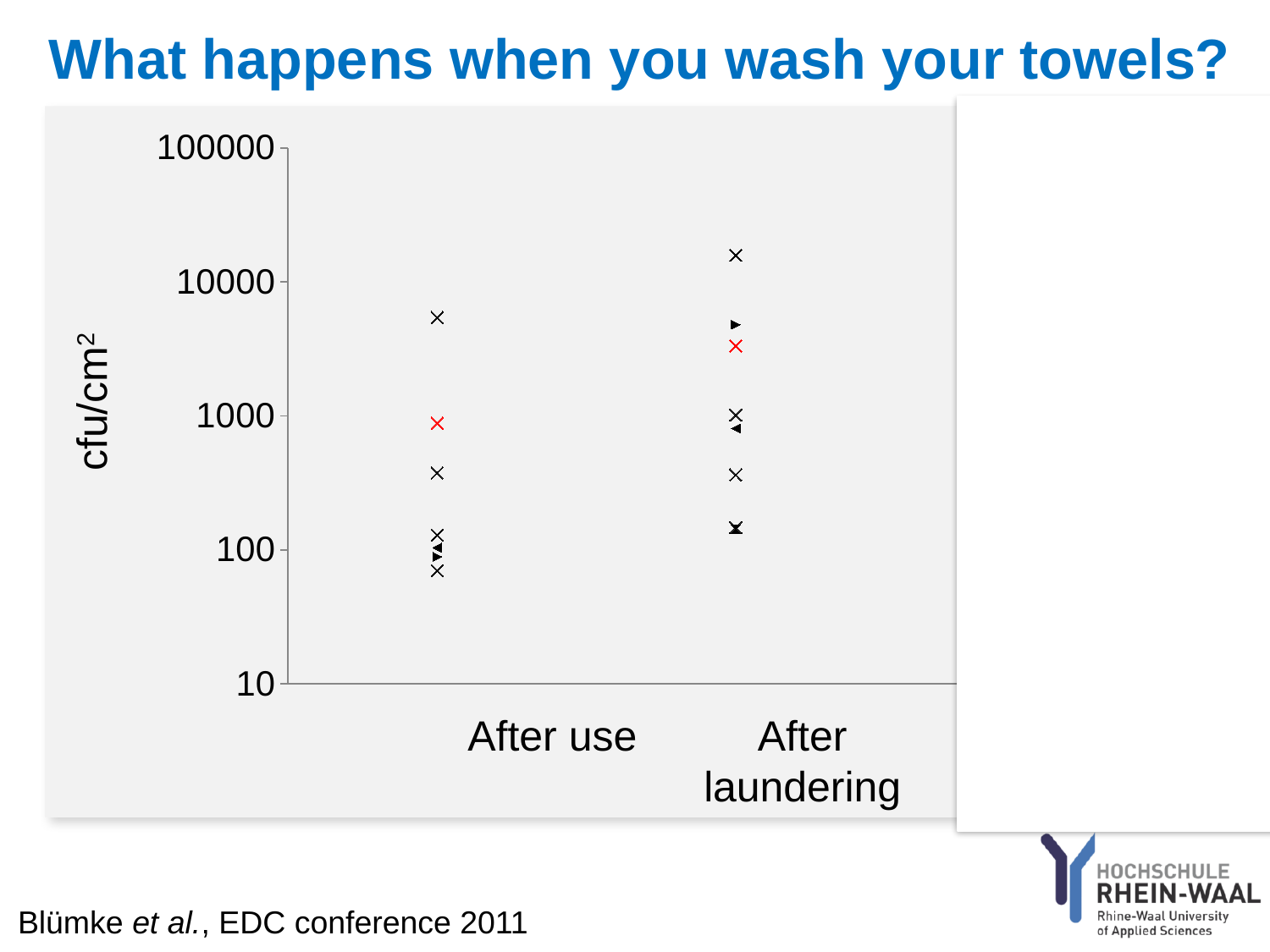
Which category contains the single highest point on the chart, "After use" or "After laundering"? After laundering Is the lowest point for "After use" greater or less than 100? less Which category contains the single lowest point on the chart, "After use" or "After laundering"? After use Is the lowest point for "After laundering" greater or less than 100? greater What kind of chart is shown on the slide? scatter chart What is the label of the y axis of the chart? cfu/cm² Is the highest point for "After laundering" greater or less than 10000? greater What is the highest tick value shown on the y axis? 100000 How many categories are shown on the x axis of the chart? 2